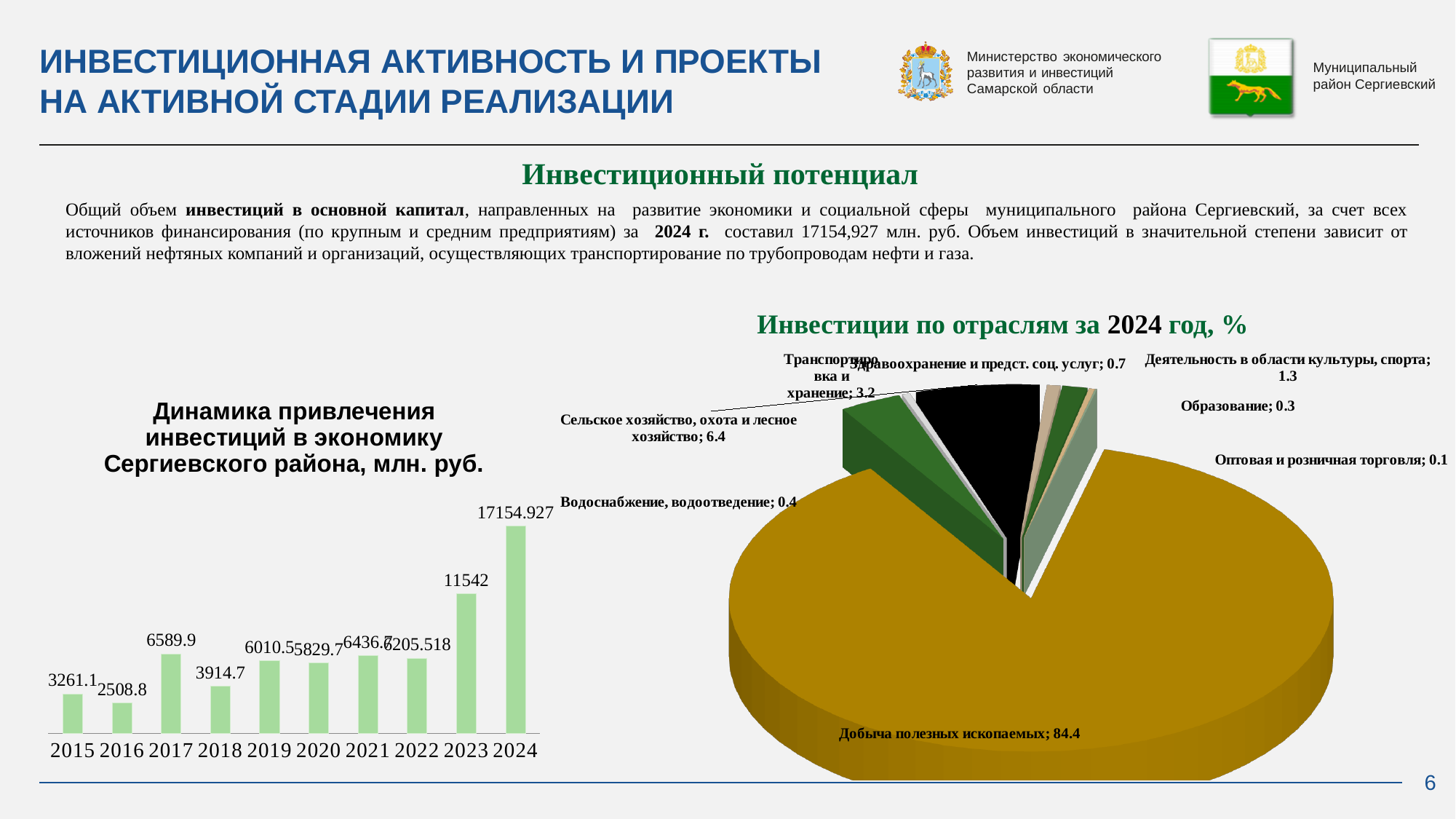
On the bar chart 'Динамика привлечения инвестиций в экономику Сергиевского района', which year has the highest value? 2024 What kind of chart is 'Динамика привлечения инвестиций в экономику Сергиевского района'? Bar chart On the bar chart 'Динамика привлечения инвестиций в экономику Сергиевского района', which year has the lowest value? 2016 What kind of chart is 'Инвестиции по отраслям за 2024 год, %'? Pie chart On the pie chart 'Инвестиции по отраслям за 2024 год, %', which sector has the smallest share? Оптовая и розничная торговля On the pie chart 'Инвестиции по отраслям за 2024 год, %', what is the value for 'Сельское хозяйство, охота и лесное хозяйство'? 6.4 On the bar chart 'Динамика привлечения инвестиций в экономику Сергиевского района', what is the value for 2024? 17154.927 On the pie chart 'Инвестиции по отраслям за 2024 год, %', what is the share for 'Добыча полезных ископаемых'? 84.4 On the bar chart 'Динамика привлечения инвестиций в экономику Сергиевского района', which is larger, the value for 2018 or the value for 2019? 2019 On the bar chart 'Динамика привлечения инвестиций в экономику Сергиевского района', what is the value for 2017? 6589.9 On the bar chart 'Динамика привлечения инвестиций в экономику Сергиевского района', what is the difference between the 2024 and 2023 values? 5612.927 How many years are shown on the bar chart 'Динамика привлечения инвестиций в экономику Сергиевского района'? 10